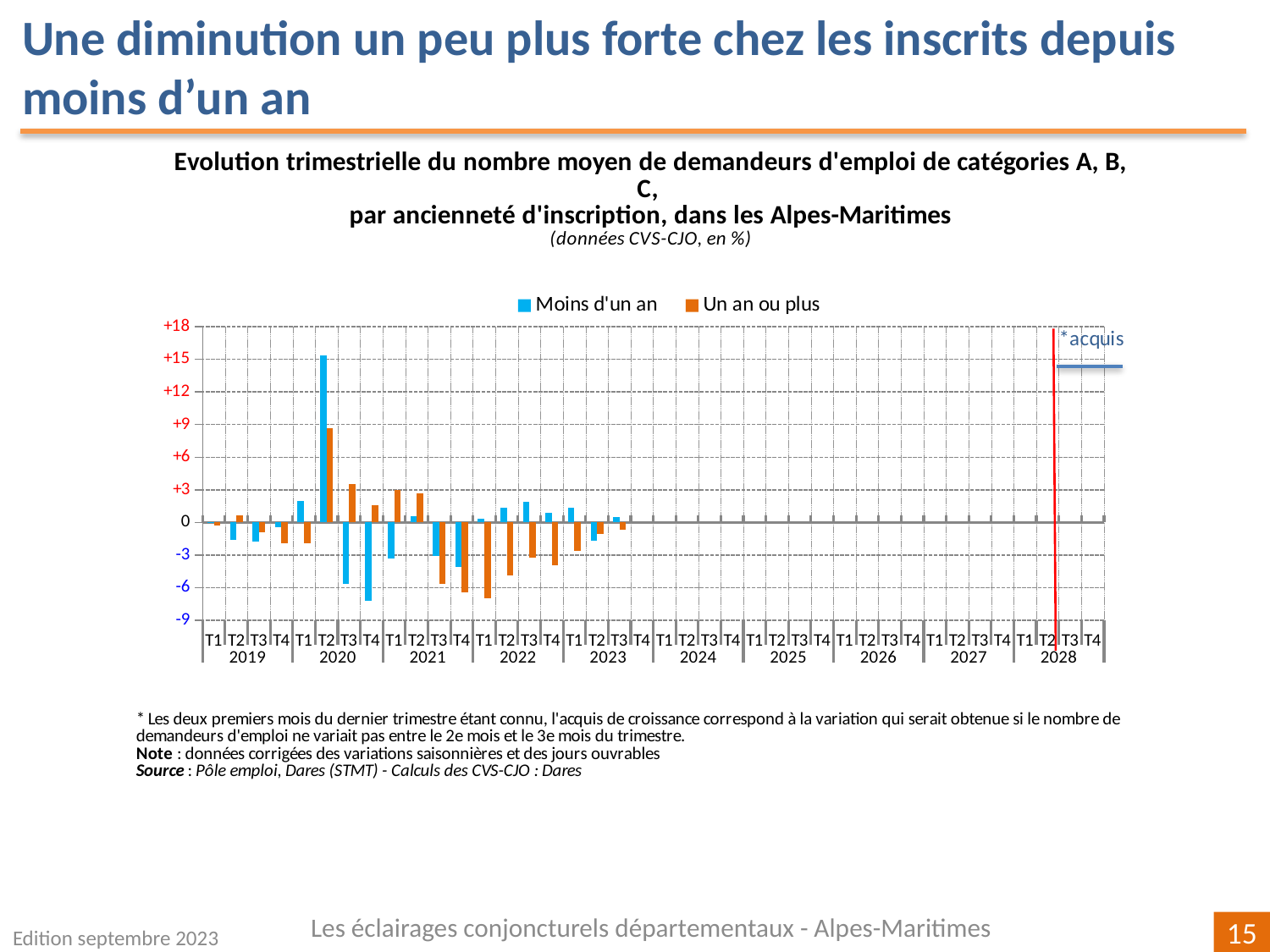
Is the value for 'Un an ou plus' in T2 2020 greater or less than +6? greater Which series is shown in orange in the legend? Un an ou plus In which quarter does the 'Moins d'un an' series reach its highest value? T2 2020 Is the value for 'Un an ou plus' in T1 2022 greater or less than -6? less Is the value for 'Moins d'un an' in T3 2020 greater or less than -3? less In T2 2020, which series has the larger value, 'Moins d'un an' or 'Un an ou plus'? Moins d'un an In T1 2021, which series has the larger value, 'Moins d'un an' or 'Un an ou plus'? Un an ou plus What kind of chart is shown on the slide? bar chart Which series is shown in blue in the legend? Moins d'un an How many series does the legend list? 2